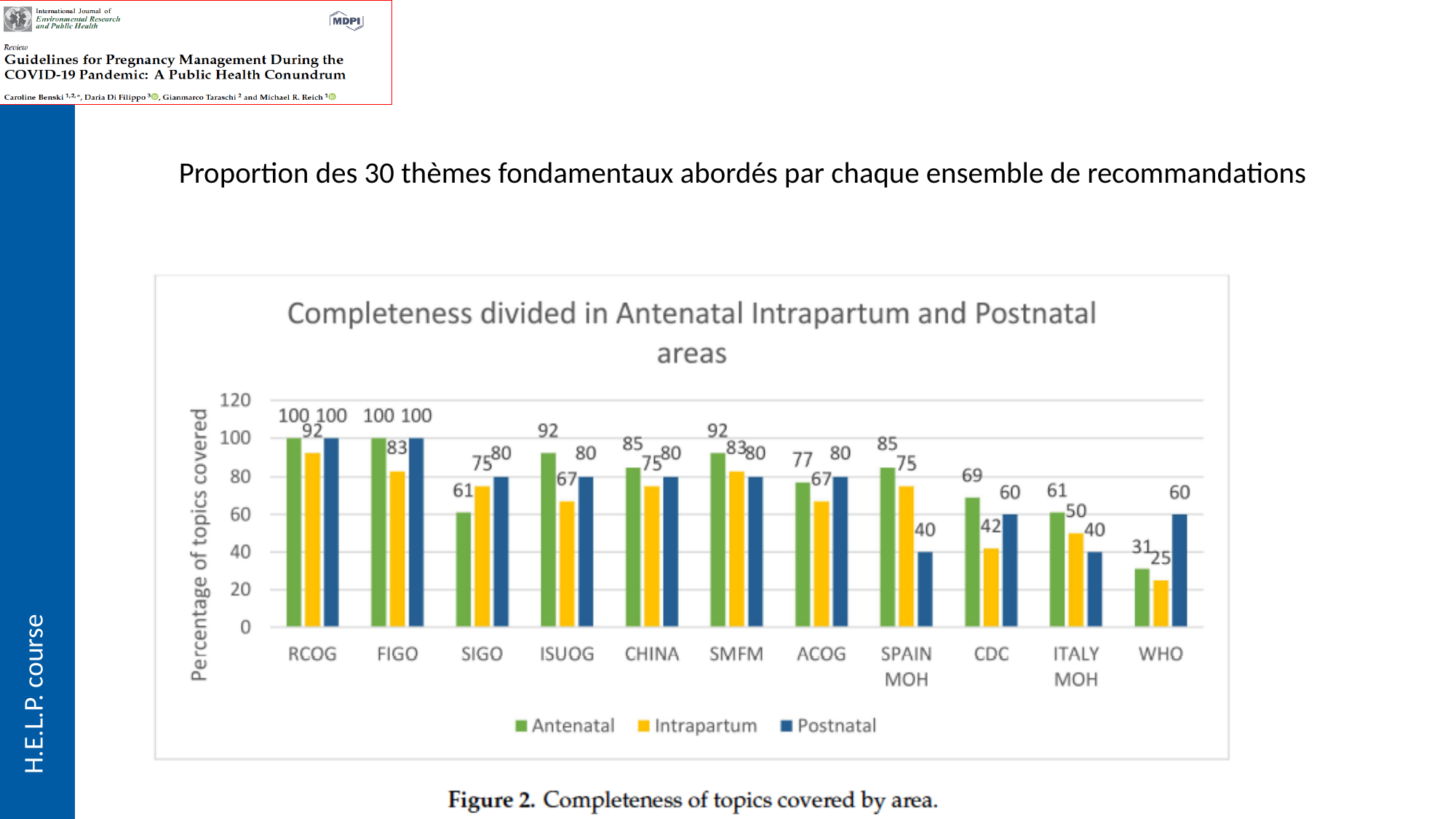
How many series does the legend list? 3 Which category has the lowest Intrapartum value? WHO What is the label of the y axis? Percentage of topics covered How many categories are shown on the x axis? 11 Which is larger for ACOG, the Antenatal value or the Postnatal value? Postnatal What is the difference between the Antenatal and Intrapartum values for SIGO? 14 What is the Postnatal value for SPAIN MOH? 40 What is the Intrapartum value for CDC? 42 What kind of chart is shown? Bar chart What is the difference between the Postnatal values for WHO and ITALY MOH? 20 What is the Antenatal value for ISUOG? 92 Which category has the lowest Antenatal value? WHO